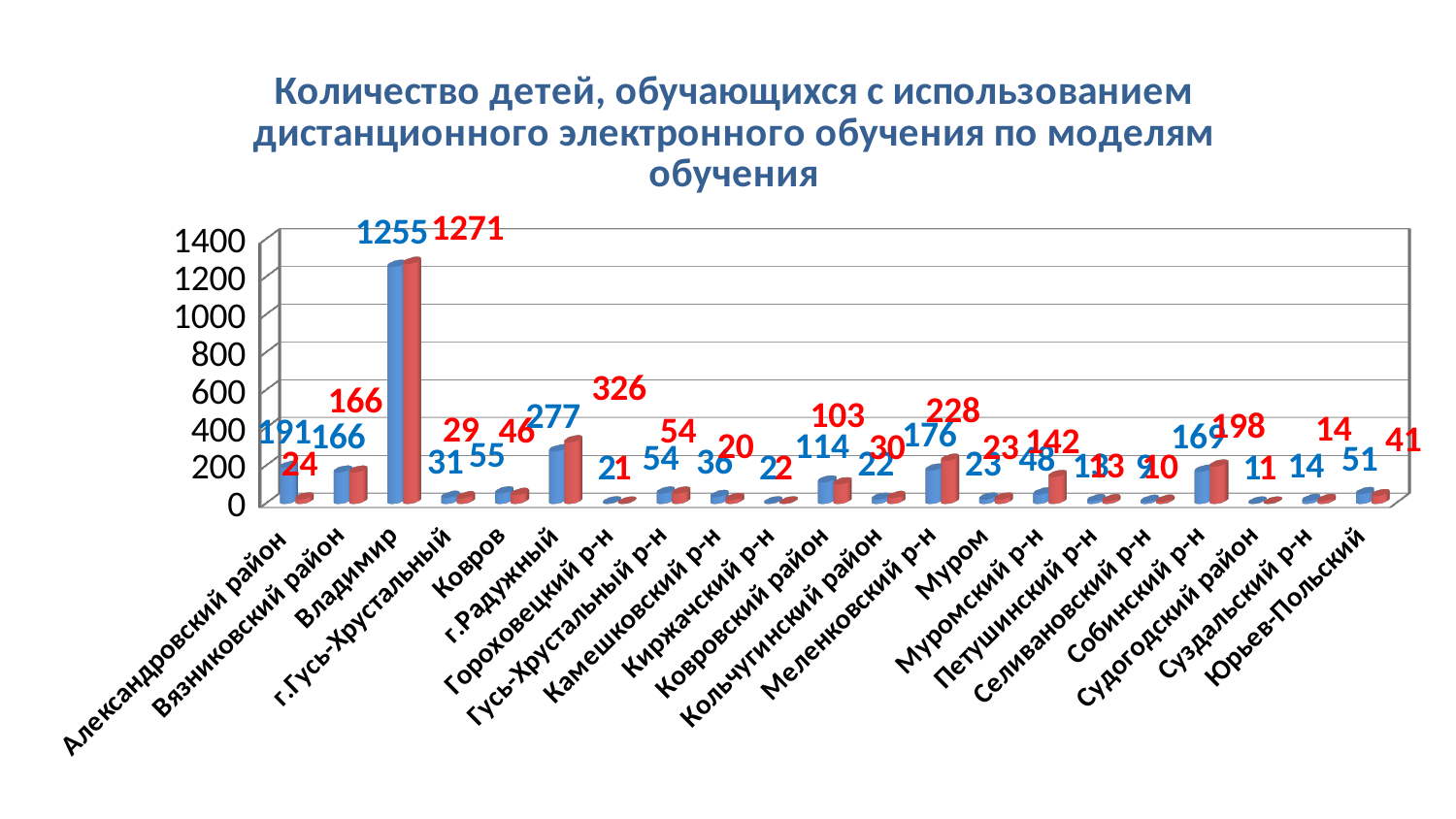
What type of chart is shown on the slide? bar chart Is the value of the blue bar for Владимир greater or less than 1000? greater What is the value of the blue bar for Владимир? 1255 What is the value of the red bar for Владимир? 1271 Which category has the highest red bar? Владимир Which is larger for Меленковский р-н, the blue bar or the red bar? the red bar What is the value of the red bar for Муромский р-н? 142 What is the value of the red bar for г.Радужный? 326 How many categories (districts) are shown on the x axis of the chart? 21 What is the difference between the blue and red bars for Александровский район? 167 What is the value of the blue bar for Александровский район? 191 What is the difference between the red and blue bars for Собинский р-н? 29